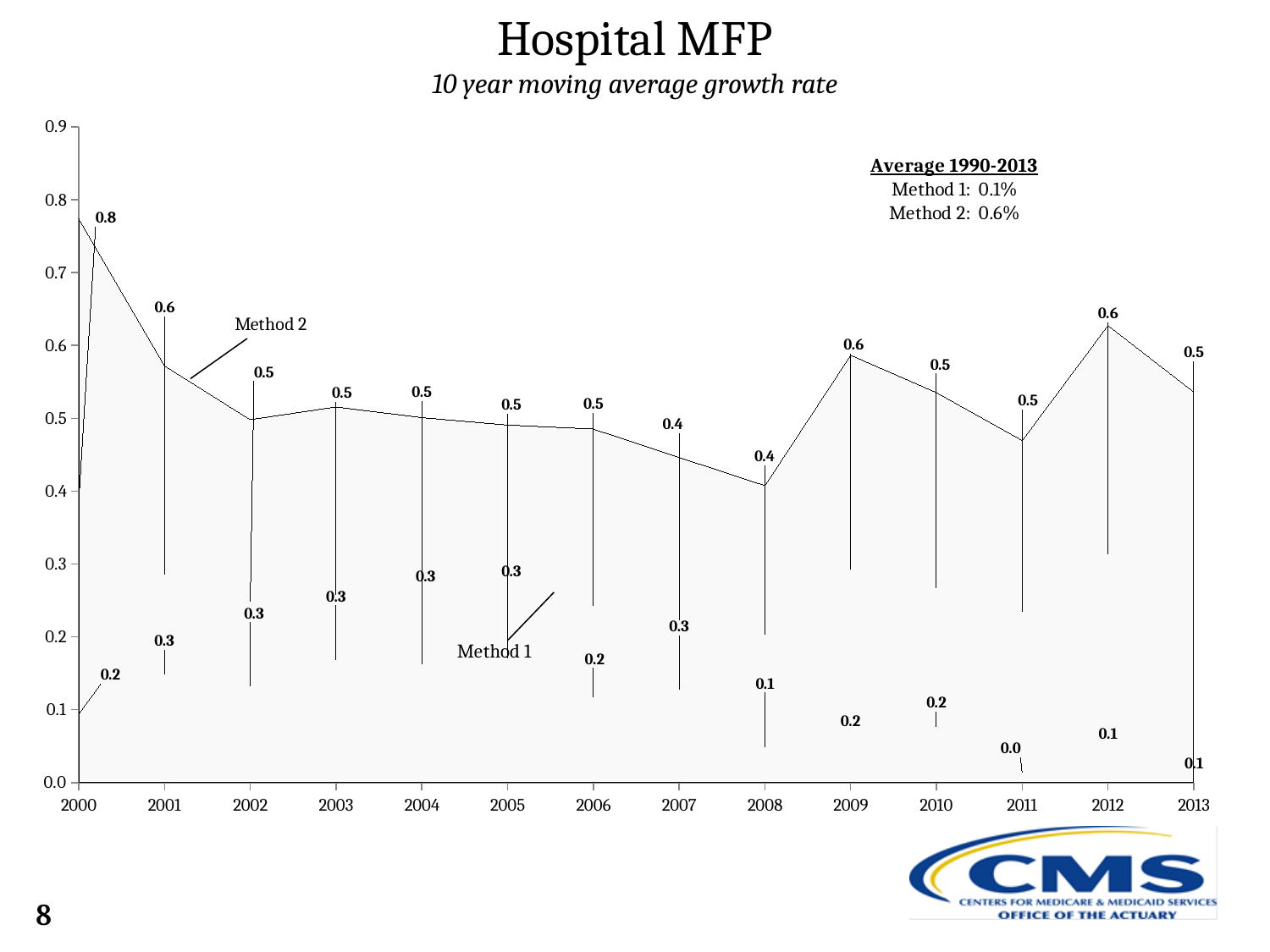
Which is larger in 2012, the Method 2 value or the Method 1 value? Method 2 In which year is the Method 2 value highest? 2000 What is the difference between the Method 2 and Method 1 values in 2000? 0.6 What is the Method 2 value for 2009? 0.6 What is the Method 1 value for 2011? 0.0 What is the Method 2 value for 2000? 0.8 How many years are shown on the x axis? 14 What is the average Method 2 growth rate for 1990-2013 stated on the slide? 0.6% What is the subtitle of the chart? 10 year moving average growth rate What is the Method 1 value for 2008? 0.1 Is the Method 2 value for 2008 greater or less than 0.3? greater In which year is the Method 1 value lowest? 2011